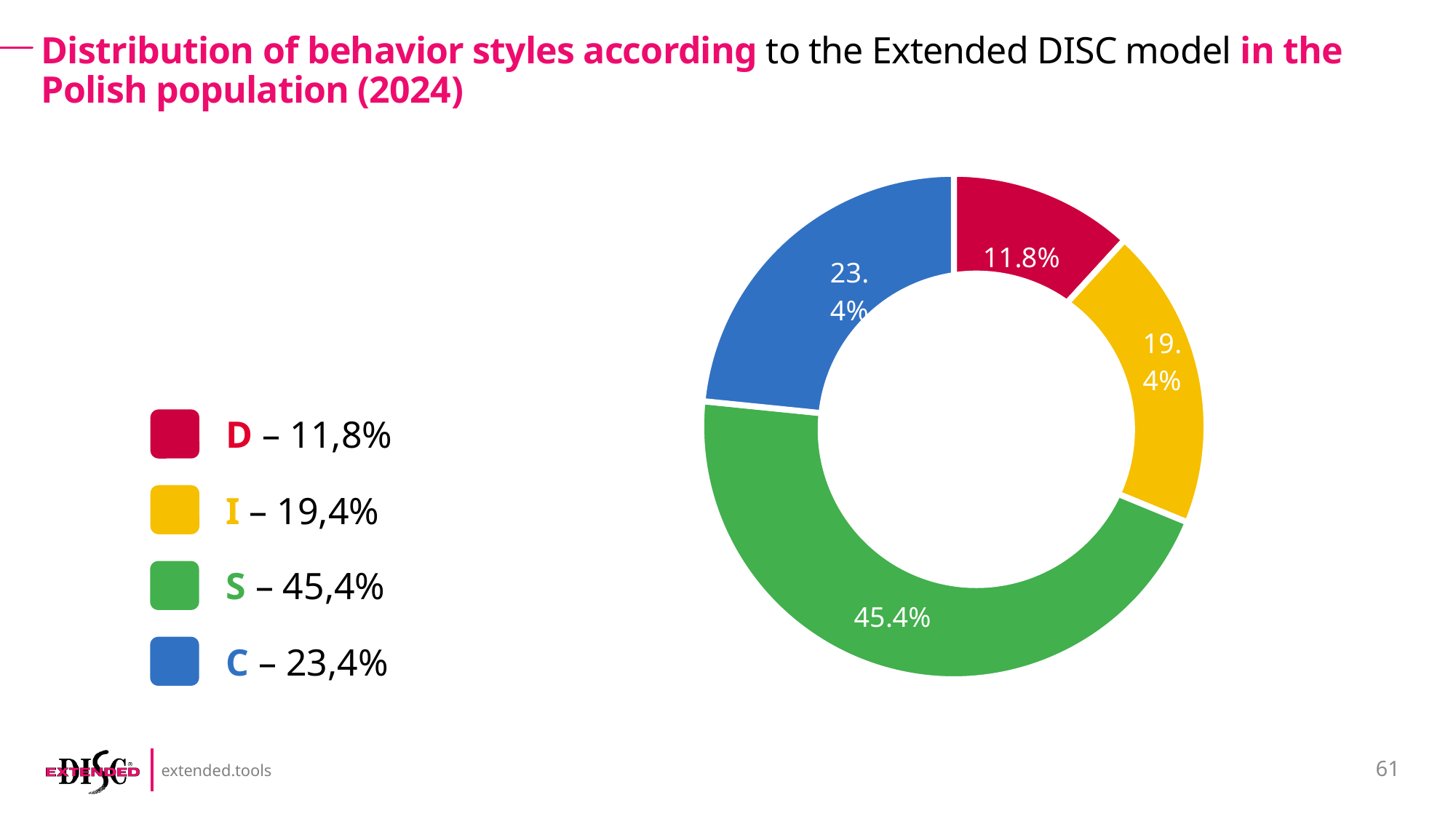
What is the difference between the I slice and the D slice? 7.6 percentage points What is the difference in percentage points between the S slice and the C slice? 22 percentage points Which behavior style has the smallest share in the chart? D What type of chart is shown on the slide? Pie chart (donut) Which behavior style has the largest share in the chart? S What percentage is shown for the C slice? 23.4% How many slices does the pie chart have? 4 Which is larger, the C slice or the I slice? C What colour is the S slice in the chart? Green What is the value of the I slice? 19.4% What percentage does the S slice represent in the pie chart? 45.4% What is the value shown for the D slice? 11.8%